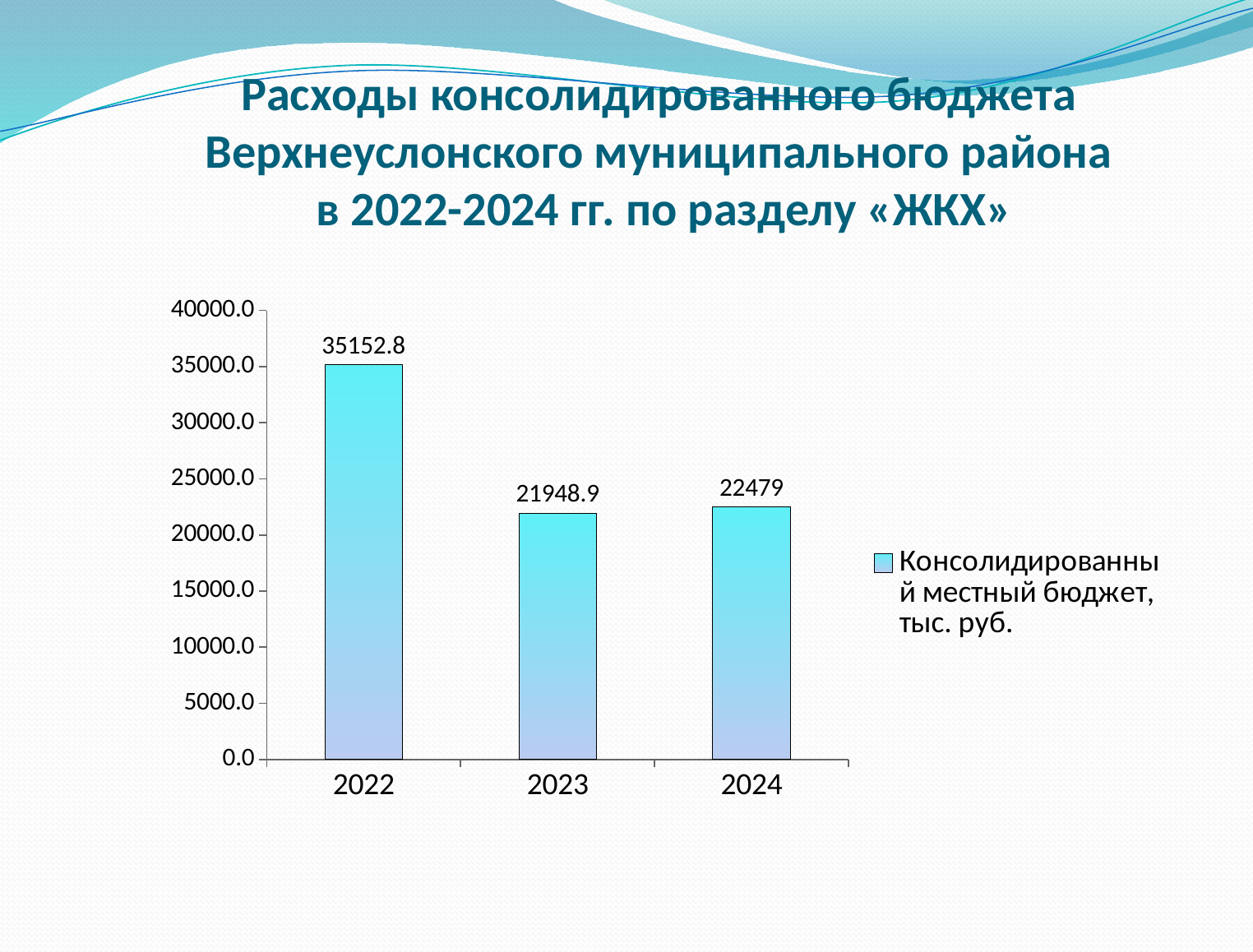
Which year has the highest value? 2022 How many years are shown on the x axis? 3 Which year has the lowest value? 2023 How many series does the legend list? 1 What is the value for 2024? 22479 What is the difference between the values for 2022 and 2023? 13203.9 What kind of chart is shown on the slide? bar chart Is the value for 2023 greater or less than 25000.0? less What is the value for 2023? 21948.9 What is the difference between the values for 2024 and 2023? 530.1 Which is larger, the value for 2022 or the value for 2024? 2022 What is the value for 2022? 35152.8